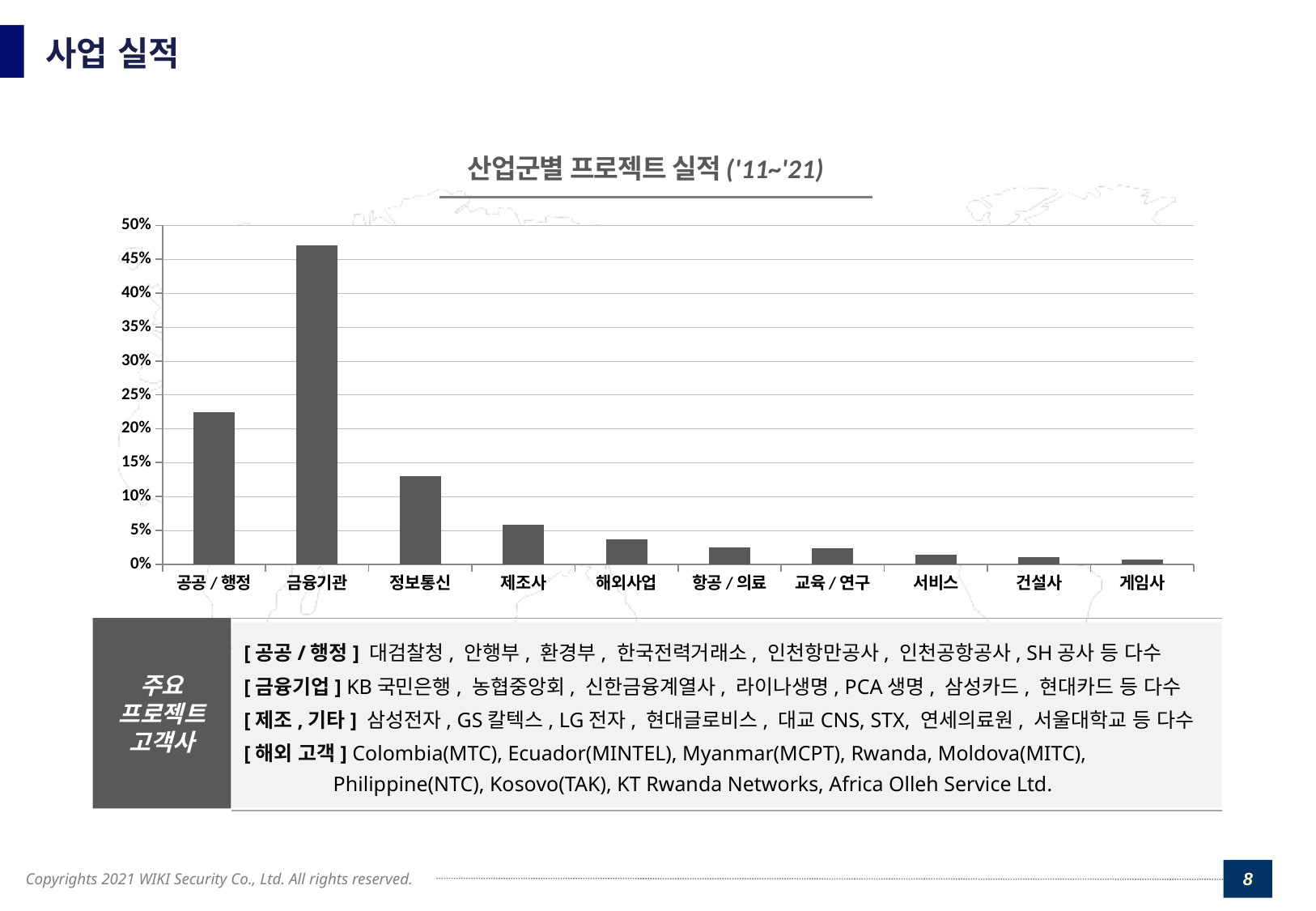
Which category has the highest value in the chart? 금융기관 Is the value for 금융기관 greater or less than 45%? greater Is the value for 정보통신 greater or less than 15%? less What is the title of the chart? 산업군별 프로젝트 실적 ('11~'21) What kind of chart is shown on the slide? bar chart Which is larger, the value for 해외사업 or the value for 서비스? 해외사업 Which category has the lowest value in the chart? 게임사 What is the maximum value shown on the y axis of the chart? 50% Is the value for 제조사 greater or less than 10%? less How many industry categories are shown on the x axis of the chart? 10 Which is larger, the value for 공공 / 행정 or the value for 정보통신? 공공 / 행정